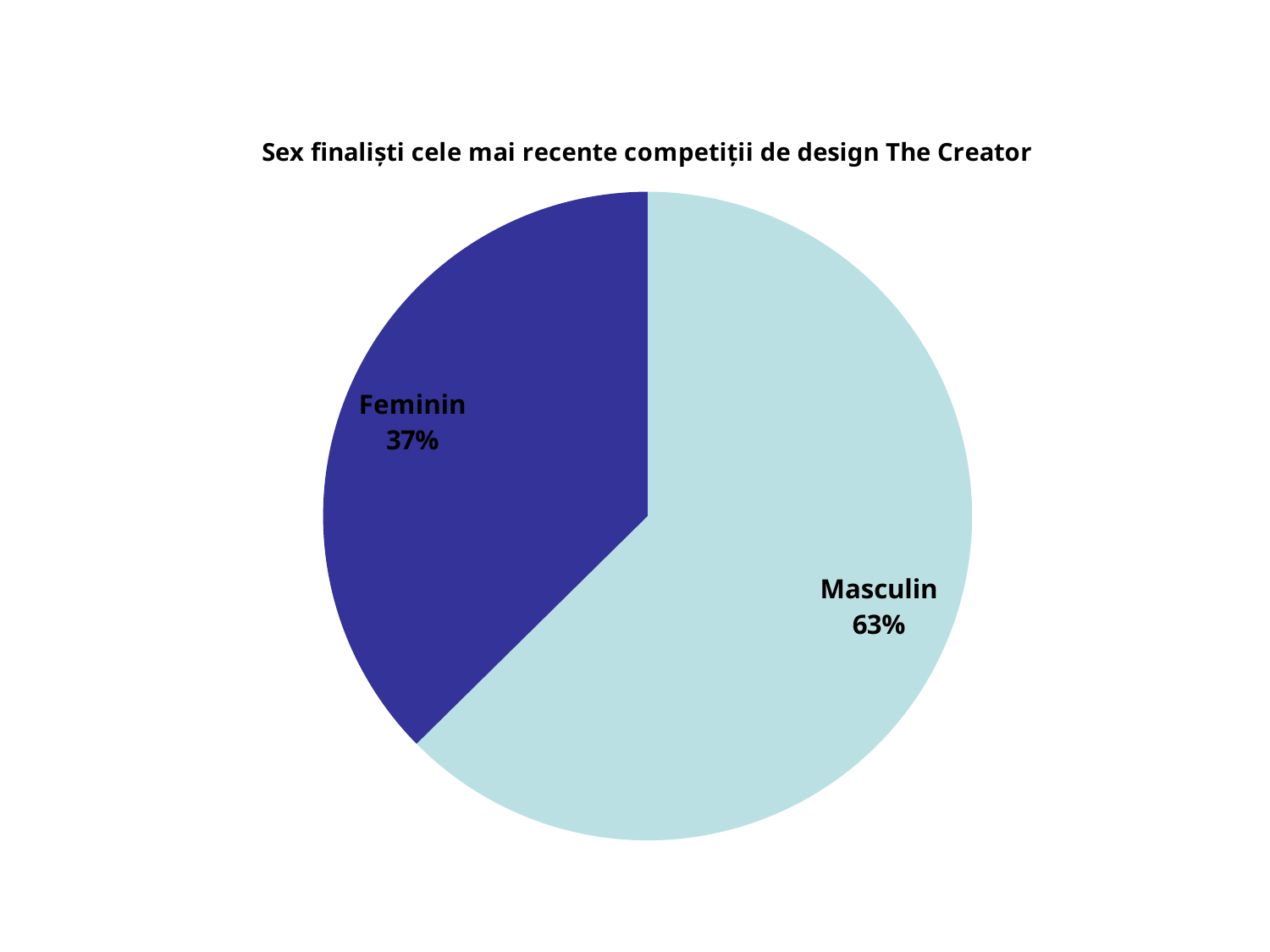
What kind of chart is shown on the slide? Pie chart Is the share for Masculin greater or less than 50%? greater How many slices does the pie chart have? 2 What is the difference in percentage points between the Masculin and Feminin slices? 26 What share of the pie does Feminin represent? 37% Which category has the largest slice of the pie? Masculin What is the title of the chart? Sex finaliști cele mai recente competiții de design The Creator What share of the pie does Masculin represent? 63% Which category has the smallest slice of the pie? Feminin Which slice is larger, Feminin or Masculin? Masculin Which category is shown in the dark blue slice? Feminin